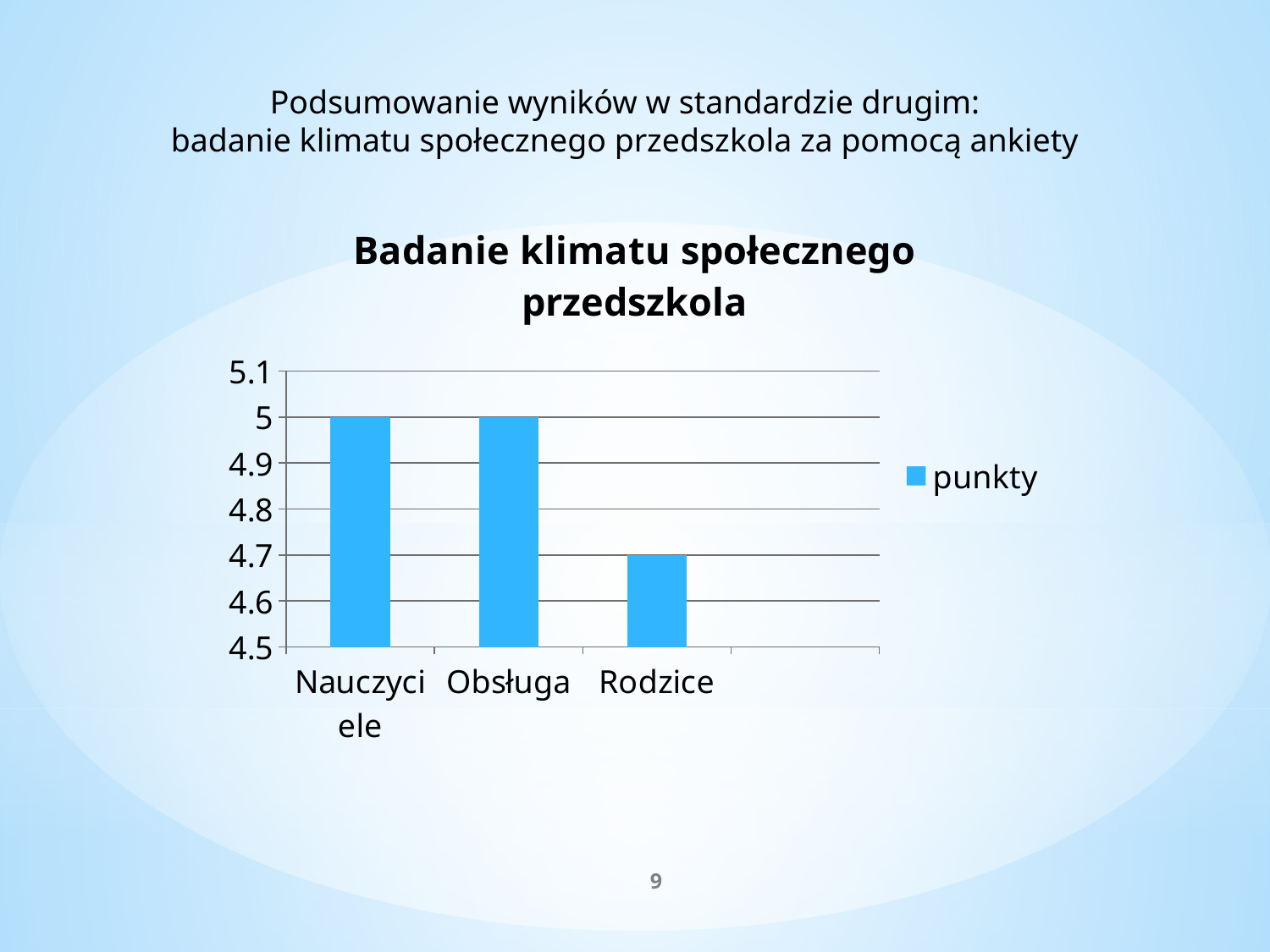
What is the name of the series in the legend? punkty How many series does the legend list? 1 Is the value for Rodzice greater or less than 4.8? less What is the value for Obsługa? 5 How many categories are shown on the x axis? 3 Which category has the lowest value? Rodzice Which is larger, the value for Nauczyciele or the value for Rodzice? Nauczyciele Is the value for Obsługa greater or less than 4.9? greater What is the difference between the values for Obsługa and Rodzice? 0.3 What is the value for Nauczyciele? 5 What kind of chart is shown? bar chart What is the value for Rodzice? 4.7